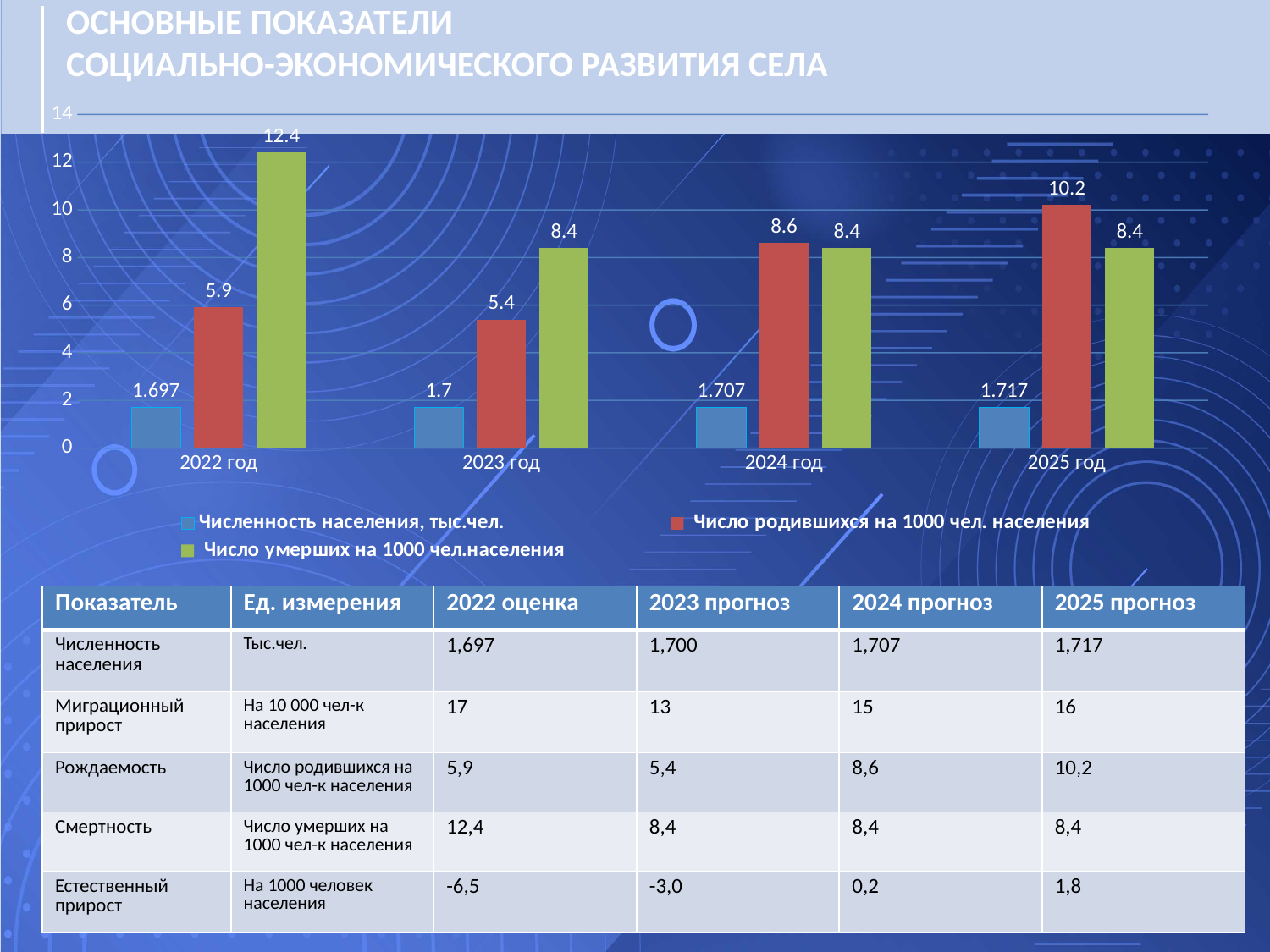
What is the value of Число родившихся на 1000 чел. населения for 2022 год? 5.9 In which year is Число родившихся на 1000 чел. населения lowest? 2023 год How many years are shown on the x axis of the chart? 4 In which year is Число родившихся на 1000 чел. населения highest? 2025 год What is the value of Число родившихся на 1000 чел. населения for 2024 год? 8.6 What is the value of Численность населения, тыс.чел. for 2025 год? 1.717 Does Число родившихся на 1000 чел. населения rise or fall from 2023 год to 2025 год? Rise In 2024 год, which is larger: Число родившихся на 1000 чел. населения or Число умерших на 1000 чел.населения? Число родившихся на 1000 чел. населения What type of chart is shown on the slide? Bar chart What is the difference between Число умерших на 1000 чел.населения and Число родившихся на 1000 чел. населения in 2022 год? 6.5 How many series does the chart legend list? 3 What is the value of Число умерших на 1000 чел.населения for 2022 год? 12.4